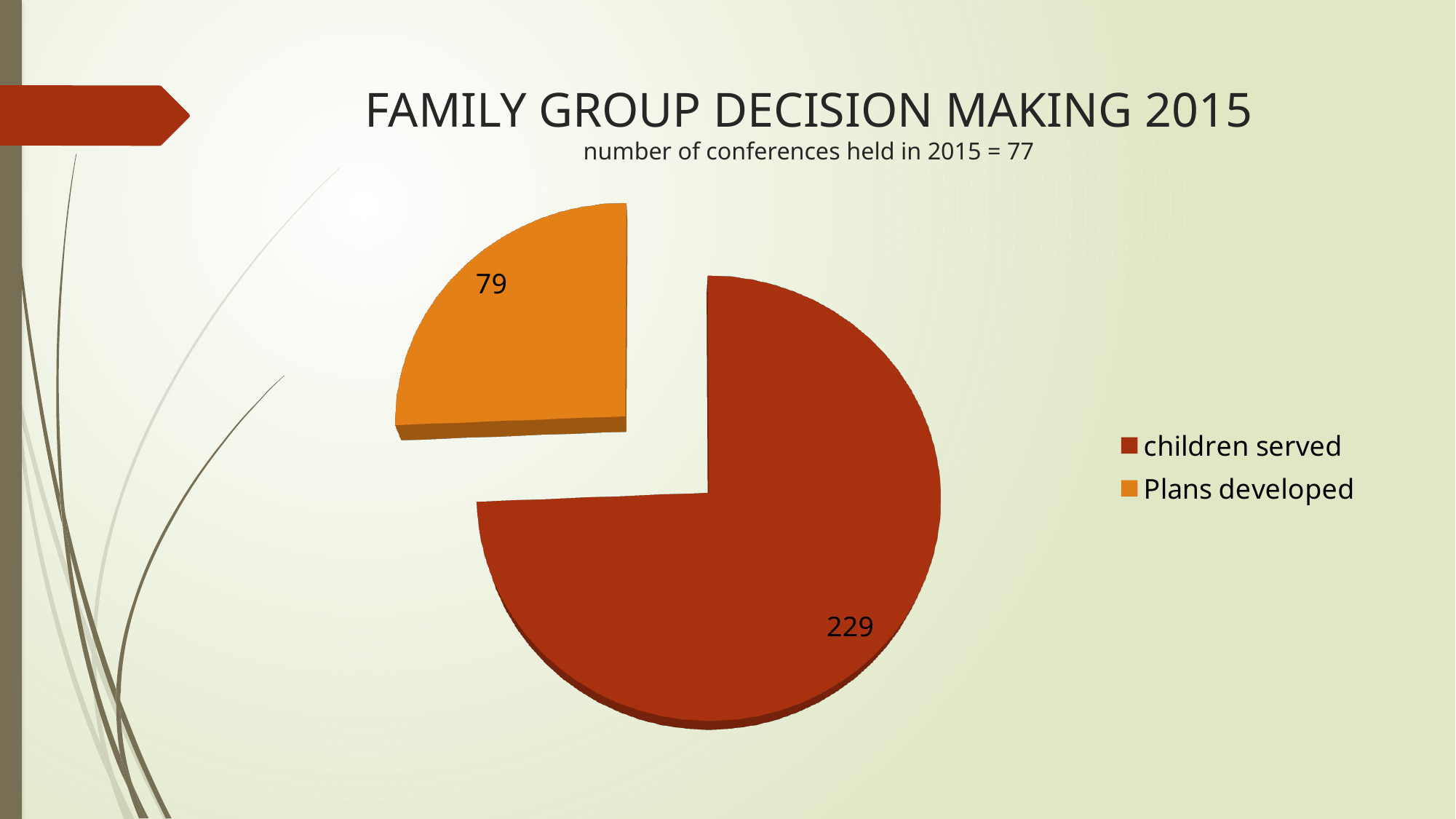
What is the value for children served? 229 What is the value for Plans developed? 79 What colour is the slice for Plans developed? orange How many slices does the pie chart have? 2 What is the total of the two slices in the pie chart? 308 Which category has the largest slice of the pie? children served How many entries does the legend list? 2 Which is larger, children served or Plans developed? children served What kind of chart is shown on the slide? pie chart According to the slide subtitle, how many conferences were held in 2015? 77 What is the difference between children served and Plans developed? 150 Which category has the smallest slice of the pie? Plans developed